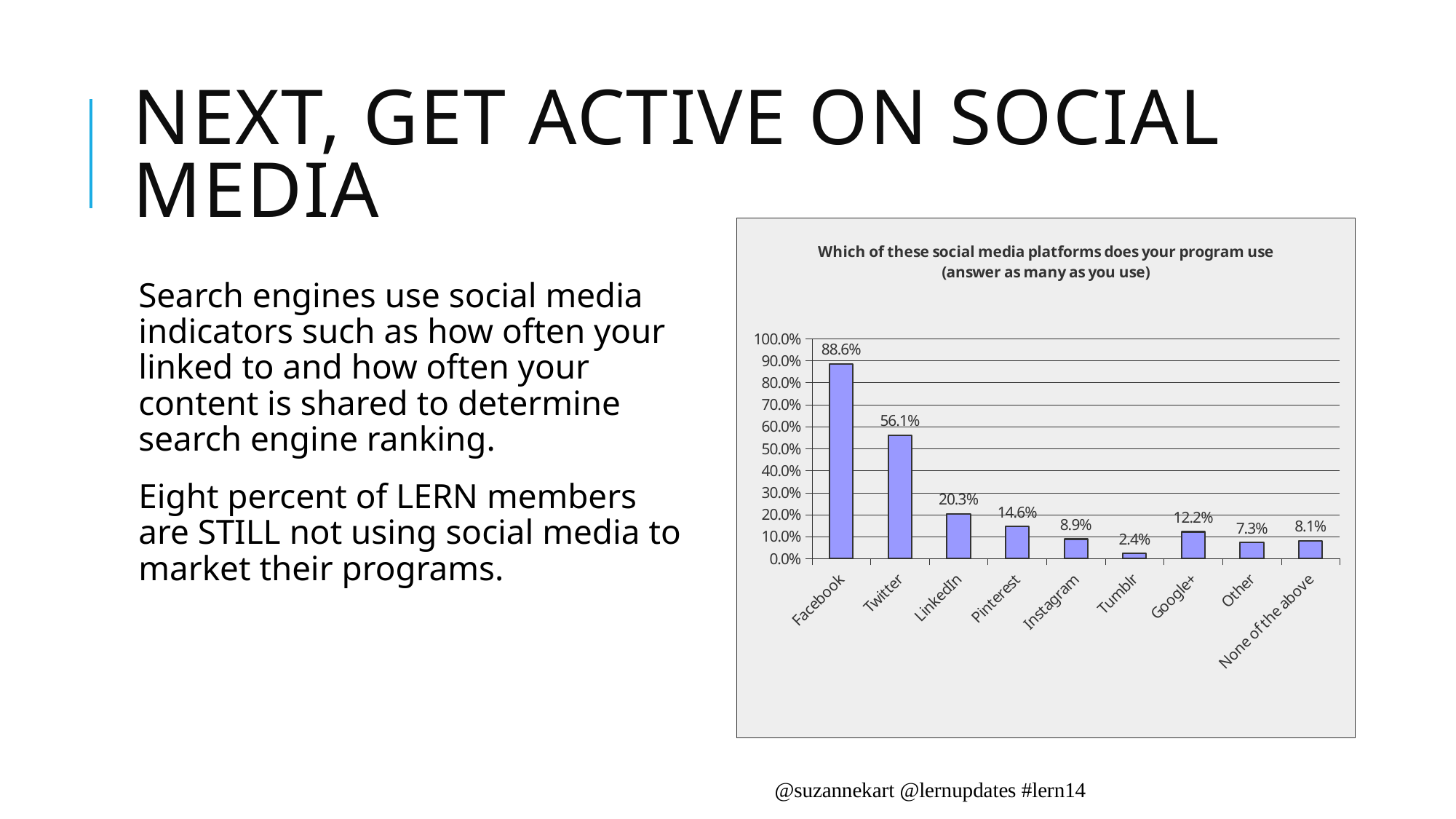
Is the value for Google+ greater or less than 10.0%? greater What percentage of programs use Twitter? 56.1% Which is larger, the value for LinkedIn or the value for Pinterest? LinkedIn How many categories are shown on the x axis? 9 What is the title of the chart? Which of these social media platforms does your program use (answer as many as you use) What percentage of programs use Facebook? 88.6% Which category has the lowest value? Tumblr What is the value shown for Tumblr? 2.4% What is the value shown for None of the above? 8.1% What kind of chart is shown on the slide? Bar chart Which platform has the highest value? Facebook What is the difference between the Facebook and Twitter values? 32.5%